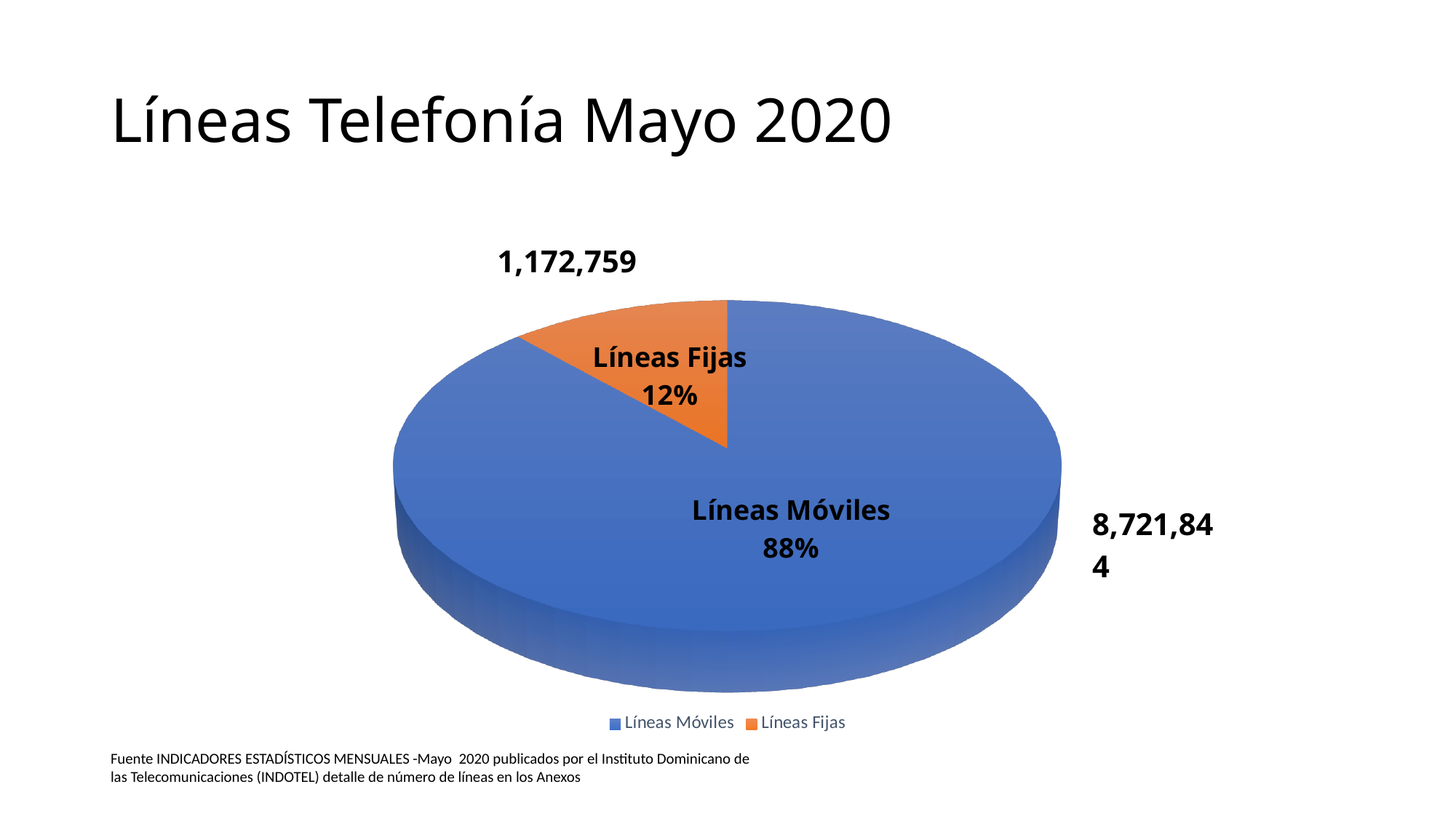
What percentage share of the pie does Líneas Fijas have? 12% What is the title of the slide containing the chart? Líneas Telefonía Mayo 2020 Which category has the largest slice of the pie? Líneas Móviles Which category has the smallest slice of the pie? Líneas Fijas What kind of chart is shown on the slide? pie chart Which is larger, Líneas Móviles or Líneas Fijas? Líneas Móviles What is the difference between the values for Líneas Móviles and Líneas Fijas? 7,549,085 What percentage share of the pie does Líneas Móviles have? 88% What is the total of the two values shown in the pie chart? 9,894,603 What is the value shown for Líneas Fijas? 1,172,759 How many slices does the pie chart have? 2 What is the value shown for Líneas Móviles? 8,721,844